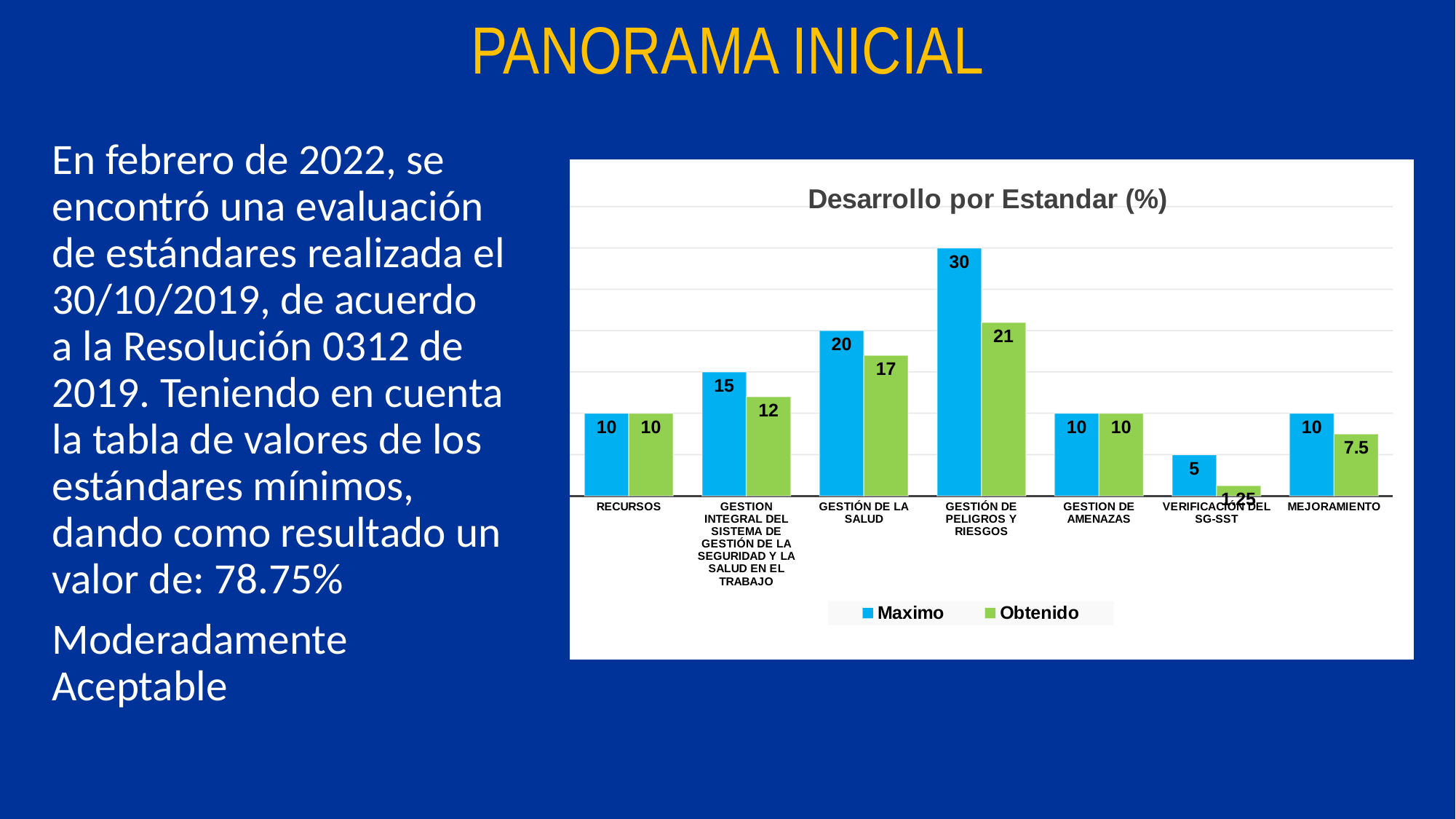
Which category has the highest Obtenido value? GESTIÓN DE PELIGROS Y RIESGOS What is the Obtenido value for VERIFICACIÓN DEL SG-SST? 1.25 What kind of chart is shown on the slide? Bar chart How many series does the legend list? 2 What is the title of the chart? Desarrollo por Estandar (%) How many categories are shown on the x axis? 7 Which is larger: the Obtenido value for GESTION INTEGRAL DEL SISTEMA DE GESTIÓN DE LA SEGURIDAD Y LA SALUD EN EL TRABAJO or the Obtenido value for RECURSOS? GESTION INTEGRAL DEL SISTEMA DE GESTIÓN DE LA SEGURIDAD Y LA SALUD EN EL TRABAJO Which category has the lowest Maximo value? VERIFICACIÓN DEL SG-SST What is the Maximo value for GESTIÓN DE PELIGROS Y RIESGOS? 30 What is the difference between the Maximo and Obtenido values for GESTIÓN DE PELIGROS Y RIESGOS? 9 What is the Obtenido value for MEJORAMIENTO? 7.5 What is the Obtenido value for GESTIÓN DE LA SALUD? 17